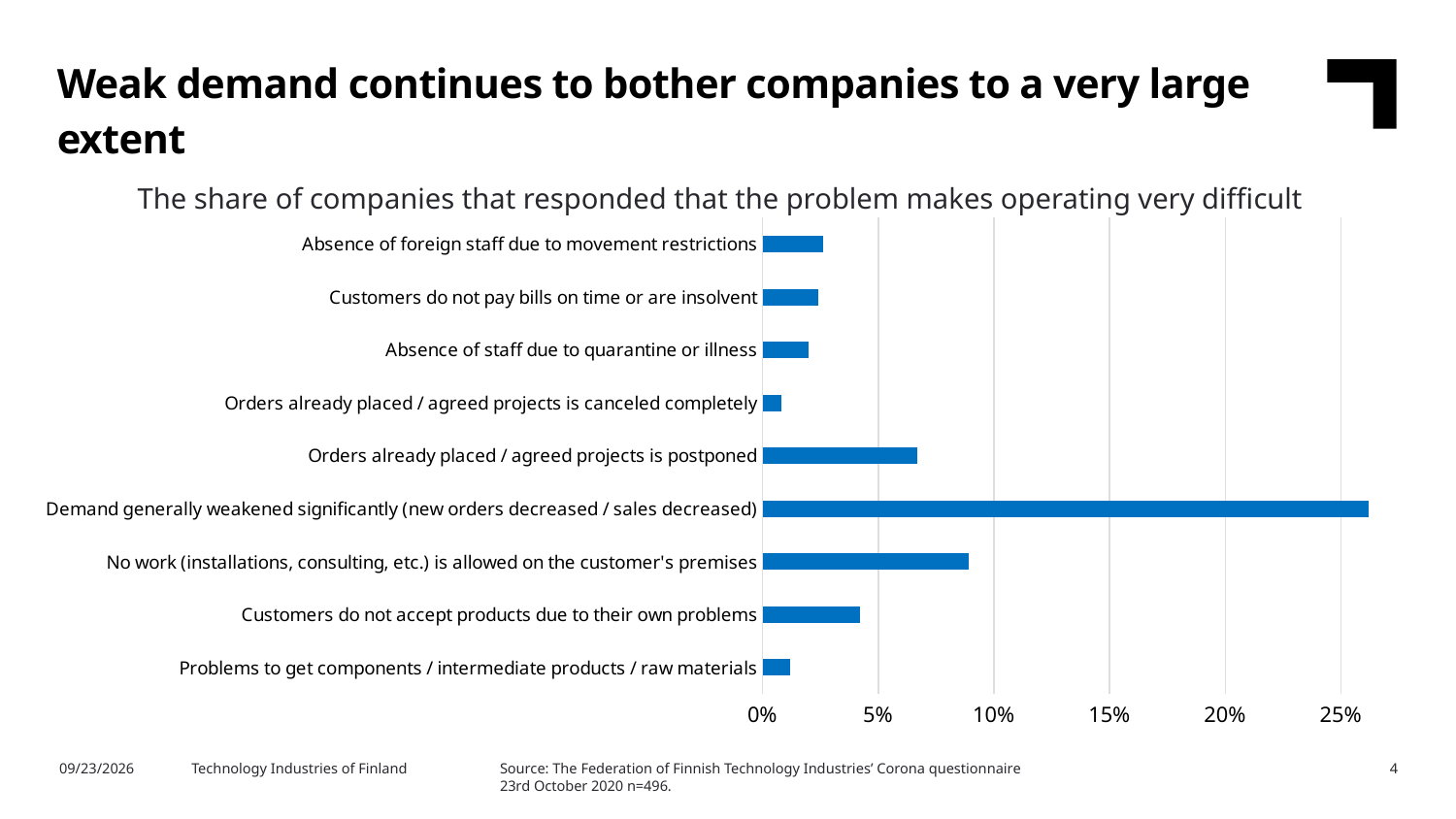
Which is larger: the value for 'Customers do not accept products due to their own problems' or the value for 'Problems to get components / intermediate products / raw materials'? Customers do not accept products due to their own problems How many categories (problems) are plotted in the chart? 9 Is the value for 'Customers do not accept products due to their own problems' greater or less than 5%? less Which problem has the highest share of companies saying it makes operating very difficult? Demand generally weakened significantly (new orders decreased / sales decreased) Is the value for 'No work (installations, consulting, etc.) is allowed on the customer's premises' greater or less than 10%? less What is the title of the chart? The share of companies that responded that the problem makes operating very difficult Is the value for 'Absence of foreign staff due to movement restrictions' greater or less than 5%? less What kind of chart is shown on the slide? bar chart Which is larger: the value for 'No work (installations, consulting, etc.) is allowed on the customer's premises' or the value for 'Orders already placed / agreed projects is postponed'? No work (installations, consulting, etc.) is allowed on the customer's premises Which problem has the lowest share of companies saying it makes operating very difficult? Orders already placed / agreed projects is canceled completely